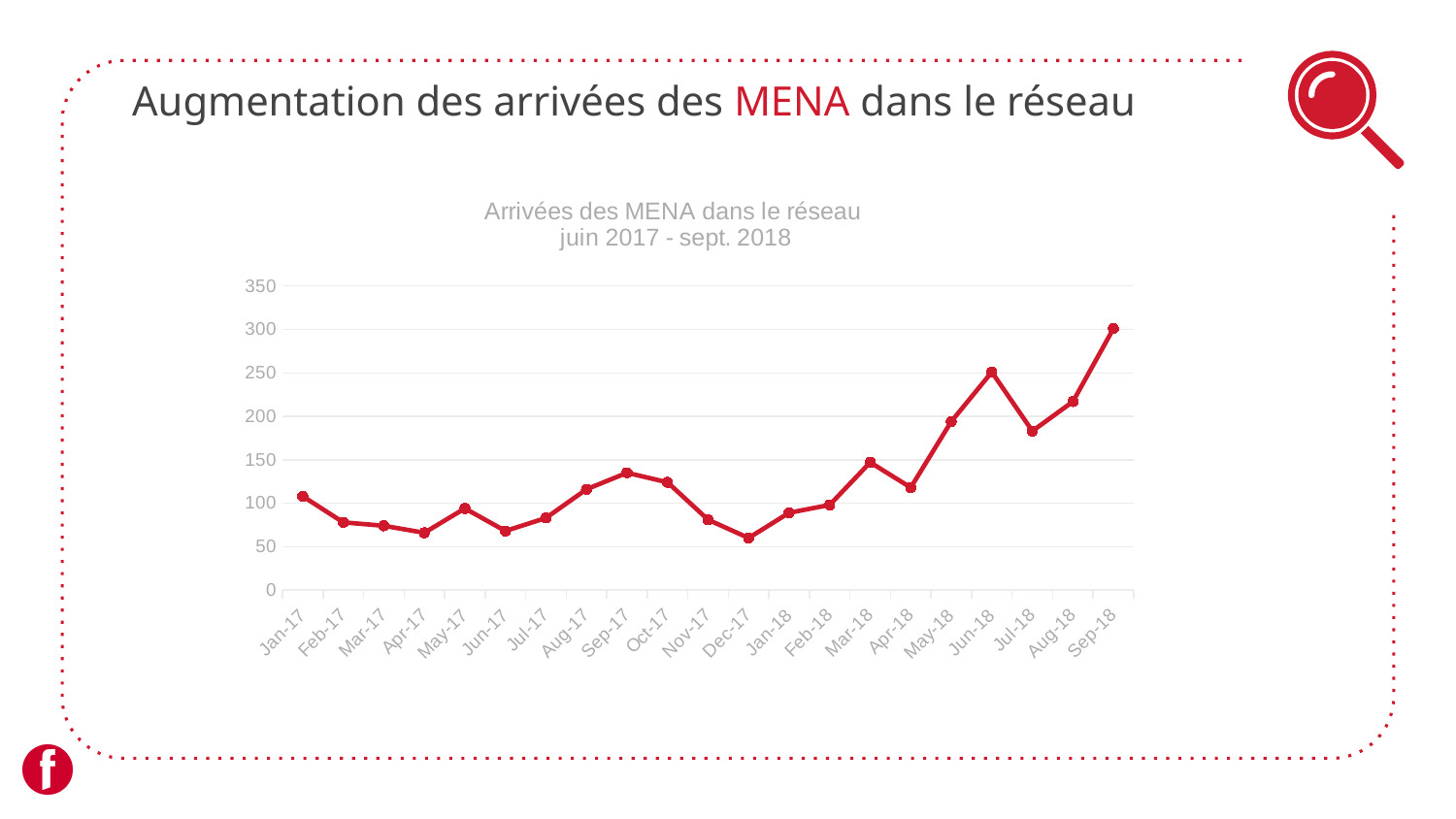
Is the value for Dec-17 greater or less than 100? less What kind of chart is shown on the slide? line chart Which month has the highest value in the chart? Sep-18 Is the value for Jun-18 greater or less than 200? greater Is the value for Apr-17 greater or less than 100? less Overall, do the values rise or fall from Jan-17 to Sep-18? rise How many months are plotted on the x axis of the chart? 21 Which is larger, the value for Sep-17 or the value for Nov-17? Sep-17 Which is larger, the value for Jun-18 or the value for Jul-18? Jun-18 What is the title of the chart? Arrivées des MENA dans le réseau juin 2017 - sept. 2018